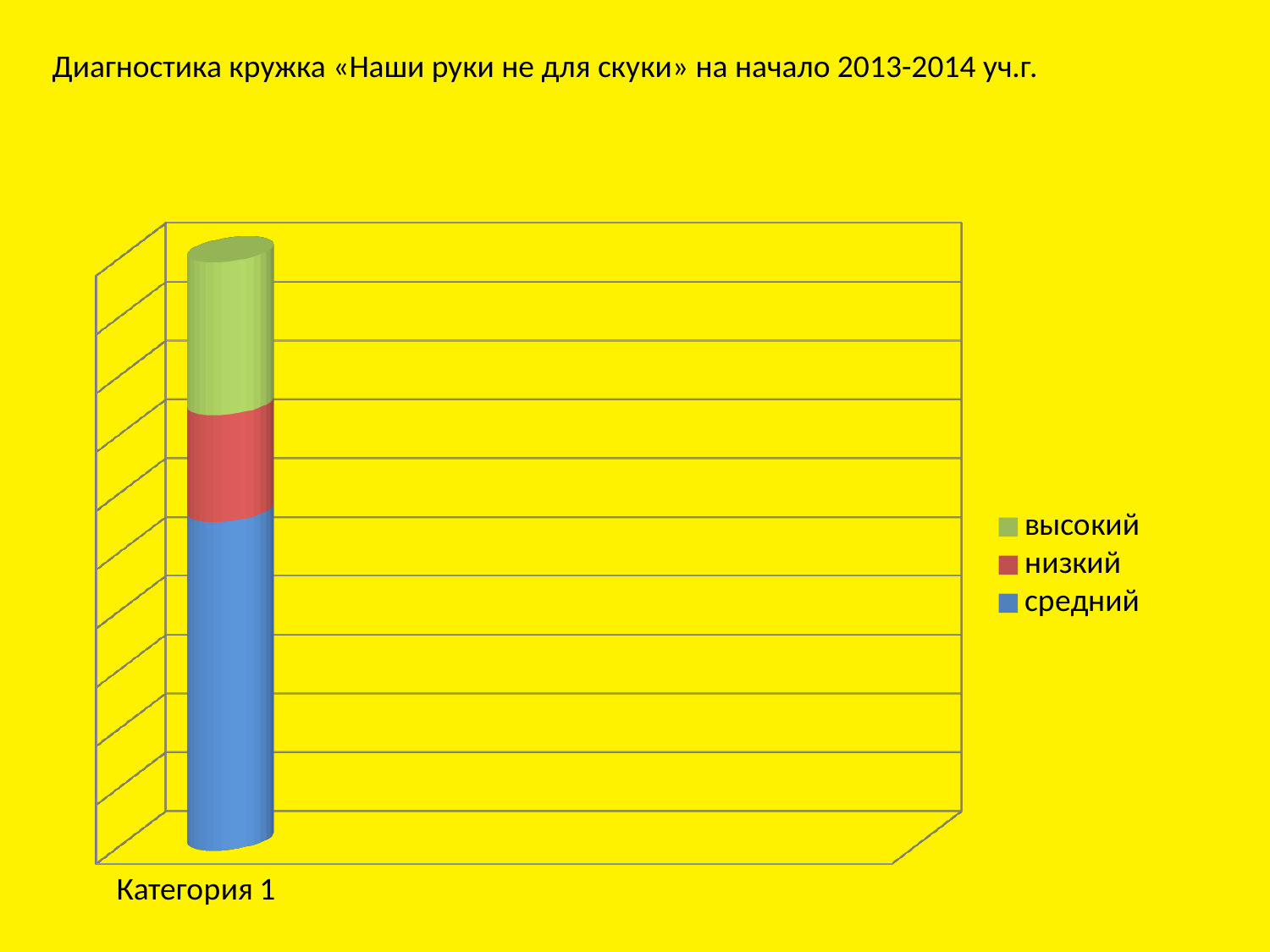
Which segment is larger in the bar for Категория 1, средний or высокий? средний How many categories are shown on the x axis? 1 What is the label of the category on the x axis? Категория 1 Which series makes up the largest segment of the bar for Категория 1? средний Which series is at the top of the stacked bar? высокий What kind of chart is shown on the slide? Stacked bar chart Which series is shown in blue? средний Which segment is larger in the bar for Категория 1, высокий or низкий? высокий How many series does the legend list? 3 Which series makes up the smallest segment of the bar for Категория 1? низкий